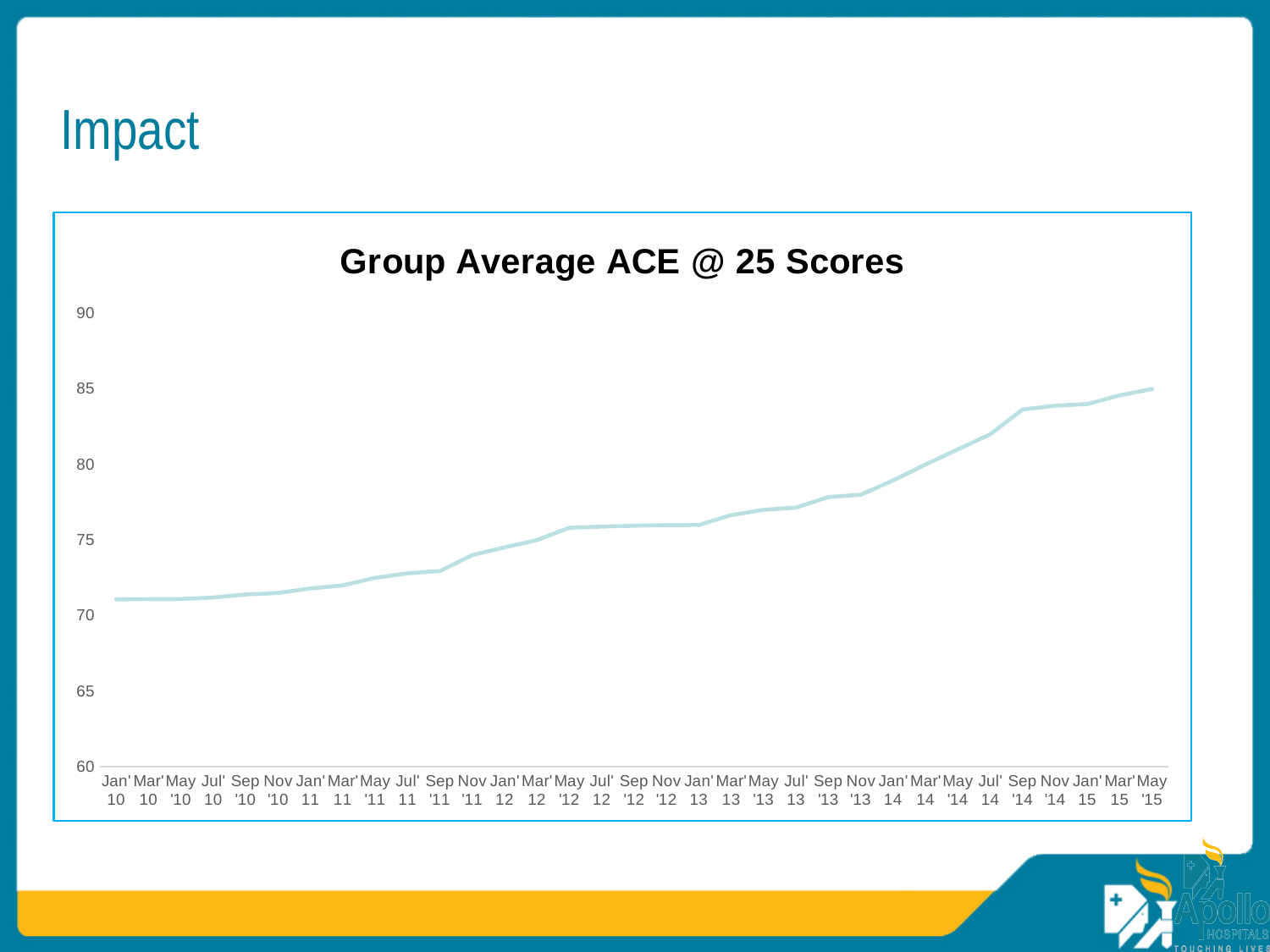
Is the value for Jan '10 greater or less than 75? less Is the value for Sep '14 greater or less than 80? greater What is the highest value shown on the y axis? 90 Is the value for Jan '13 greater or less than 75? greater How many data points are plotted along the x axis? 33 Which is larger, the value for Jan '10 or the value for May '15? May '15 Which point on the x axis has the highest Group Average ACE @ 25 Score? May '15 Do the Group Average ACE @ 25 Scores rise or fall from Jan '10 to May '15? rise What is the title of the chart? Group Average ACE @ 25 Scores What kind of chart is shown on the slide? line chart